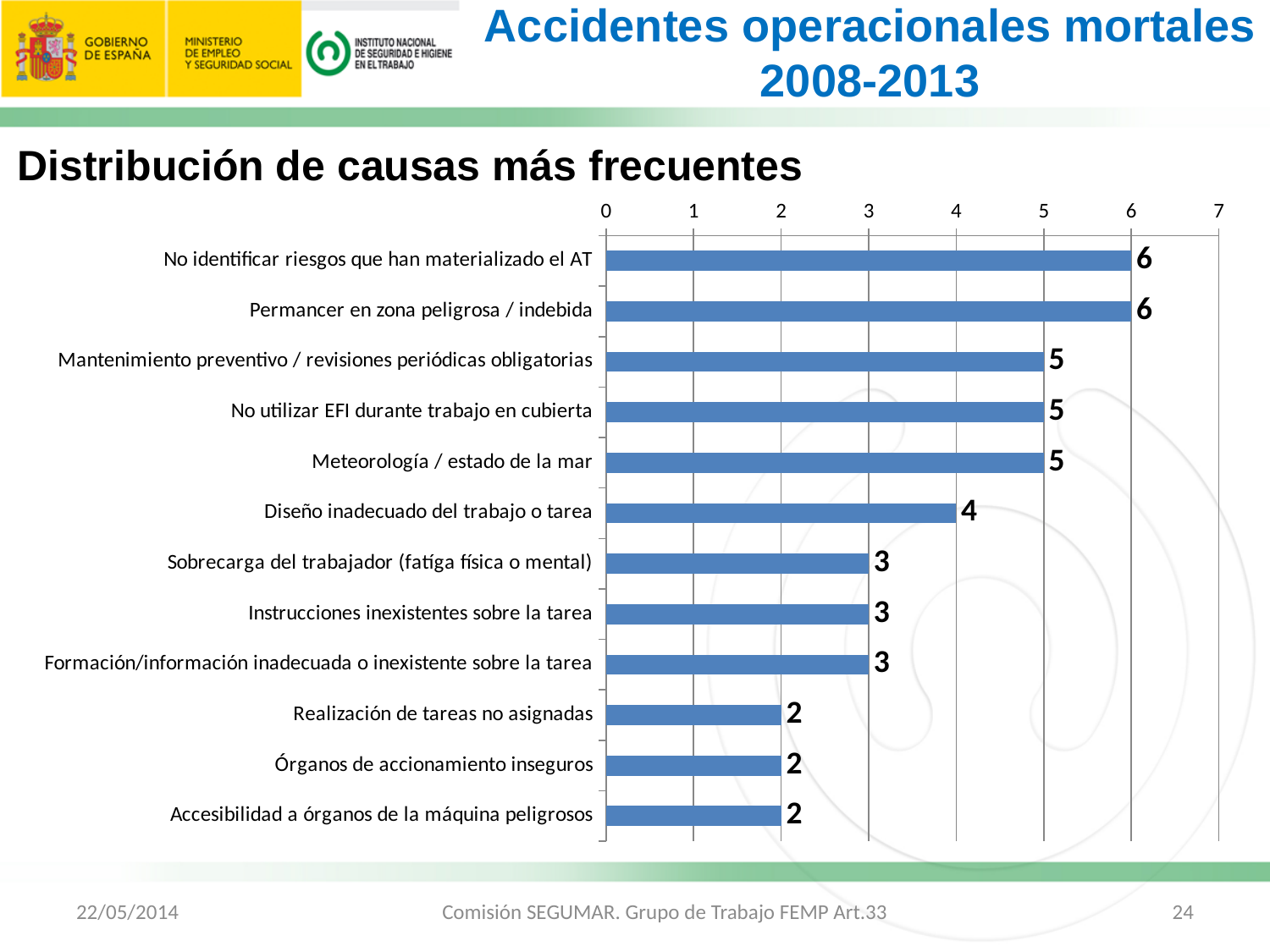
Is the value for "Permancer en zona peligrosa / indebida" greater or less than 4? greater What is the title of the chart section on the slide? Distribución de causas más frecuentes What is the lowest value shown in the chart? 2 What is the value for "Meteorología / estado de la mar"? 5 What is the value for "Sobrecarga del trabajador (fatíga física o mental)"? 3 What is the value for "Diseño inadecuado del trabajo o tarea"? 4 What is the difference between the values for "No identificar riesgos que han materializado el AT" and "Diseño inadecuado del trabajo o tarea"? 2 What is the value for "Realización de tareas no asignadas"? 2 What is the highest value shown in the chart? 6 How many categories are shown in the chart? 12 What kind of chart is shown on the slide? bar chart Which is larger: the value for "Mantenimiento preventivo / revisiones periódicas obligatorias" or the value for "Instrucciones inexistentes sobre la tarea"? Mantenimiento preventivo / revisiones periódicas obligatorias